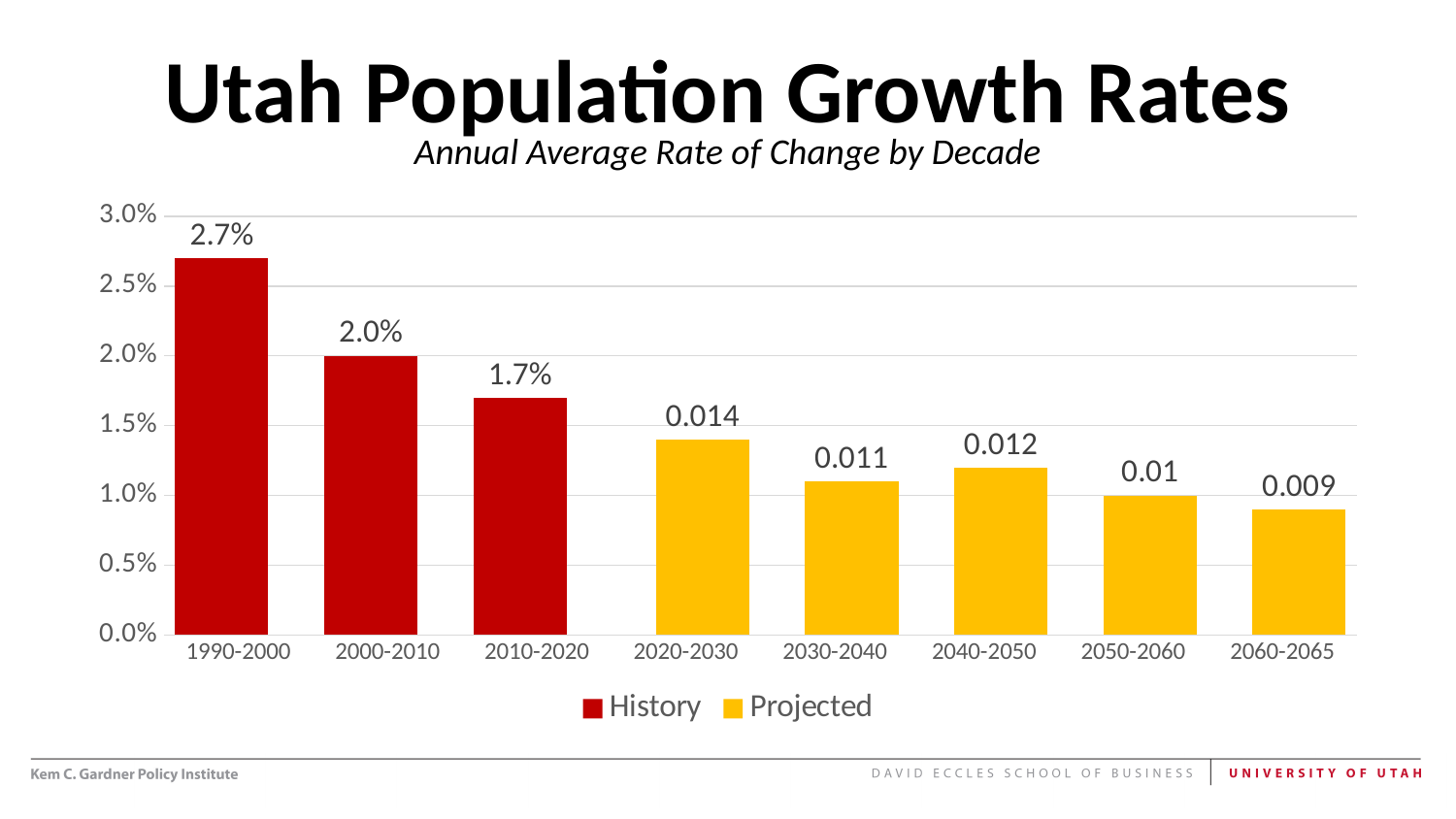
What is the value shown for 1990-2000? 2.7% What is the data label shown for 2020-2030? 0.014 What is the data label shown for 2060-2065? 0.009 Which period has the lowest growth rate? 2060-2065 Which decade has the highest growth rate? 1990-2000 How many series does the legend list? 2 Which is larger, the value for 2030-2040 or the value for 2040-2050? 2040-2050 Which legend entry is shown in red? History What is the value shown for 2010-2020? 1.7% What kind of chart is shown on the slide? Bar chart What is the difference between the values for 1990-2000 and 2000-2010? 0.7% How many decade categories are shown on the x axis? 8